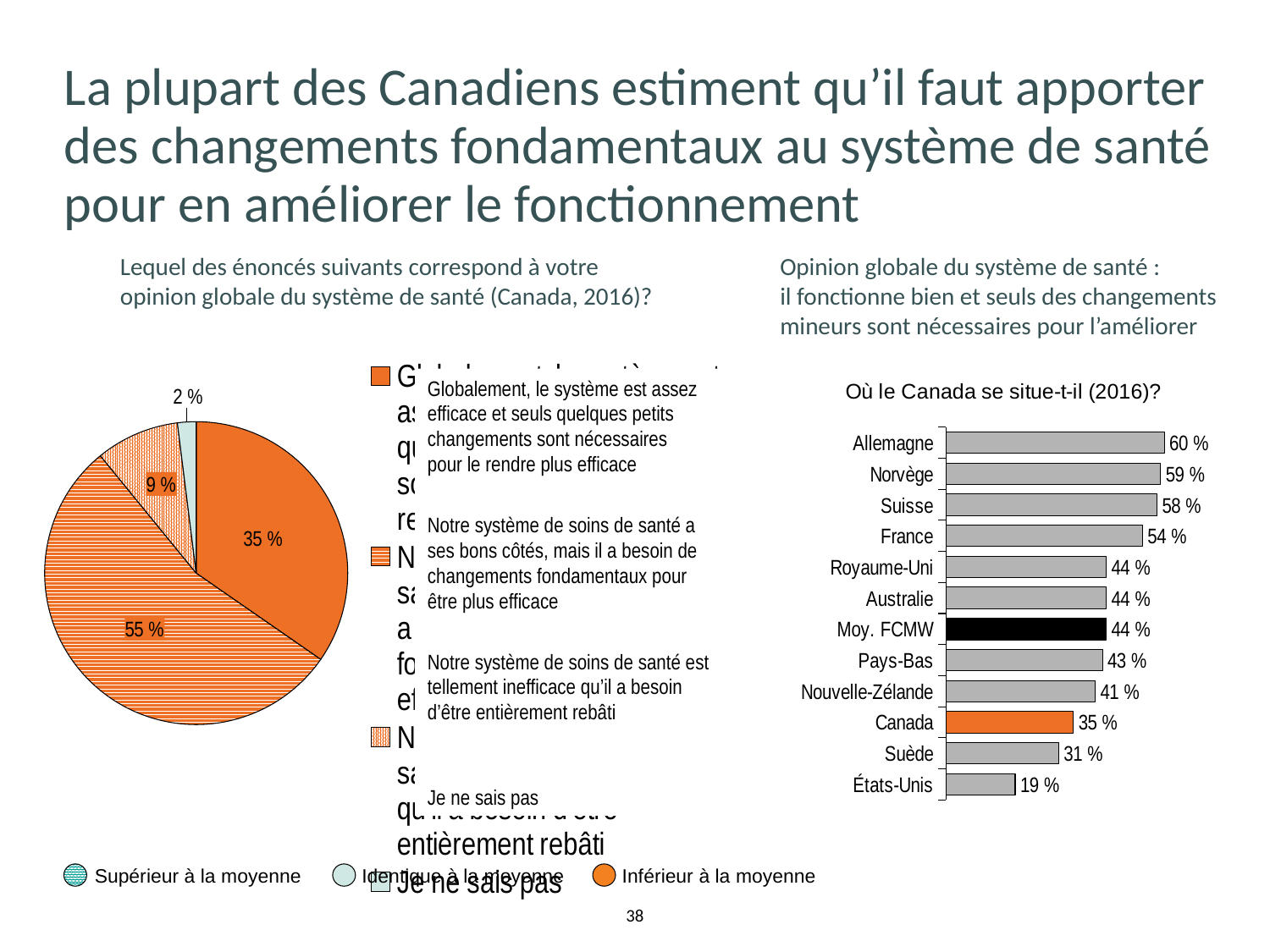
In the bar chart titled "Où le Canada se situe-t-il (2016)?", which is larger, the value for Suède or the value for Canada? Canada In the bar chart titled "Où le Canada se situe-t-il (2016)?", how many countries or averages are listed? 12 What kind of chart is the chart on the right of the slide? Bar chart In the bar chart titled "Où le Canada se situe-t-il (2016)?", what is the value for Allemagne? 60 % In the bar chart titled "Où le Canada se situe-t-il (2016)?", what is the value for Canada? 35 % In the pie chart on the left of the slide, how many slices are there? 4 In the bar chart titled "Où le Canada se situe-t-il (2016)?", what is the value for Moy. FCMW? 44 % In the pie chart on the left of the slide, what share is shown for the slice "Je ne sais pas"? 2 % In the bar chart titled "Où le Canada se situe-t-il (2016)?", which country has the lowest value? États-Unis In the bar chart titled "Où le Canada se situe-t-il (2016)?", what is the difference between the values for Allemagne and Canada? 25 % In the pie chart on the left of the slide, what is the largest slice's value? 55 % In the bar chart titled "Où le Canada se situe-t-il (2016)?", which country has the highest value? Allemagne